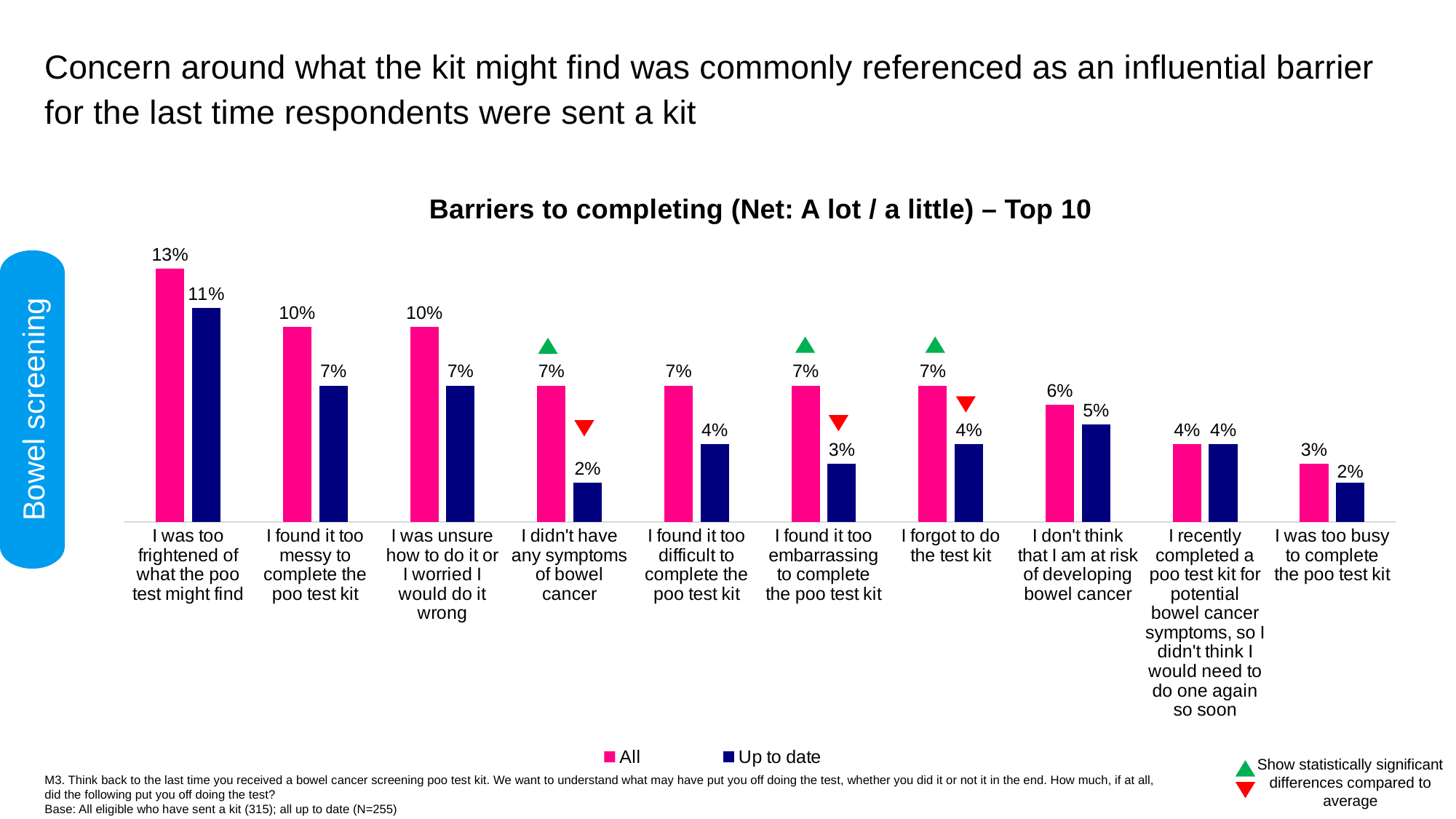
What is the title of the chart? Barriers to completing (Net: A lot / a little) – Top 10 How many series does the legend list? 2 Which is larger for 'I found it too embarrassing to complete the poo test kit': the 'All' value or the 'Up to date' value? All Which barrier has the lowest value for the 'All' series? I was too busy to complete the poo test kit What is the value for 'Up to date' for 'I didn't have any symptoms of bowel cancer'? 2% What is the value for 'All' for 'I was too frightened of what the poo test might find'? 13% Which barrier has the highest value for the 'All' series? I was too frightened of what the poo test might find What kind of chart is shown on the slide? Bar chart What is the value for 'Up to date' for 'I don't think that I am at risk of developing bowel cancer'? 5% What is the difference between the 'All' and 'Up to date' values for 'I found it too messy to complete the poo test kit'? 3% Do the 'All' values rise or fall from left to right across the barriers? Fall How many barriers are shown on the chart? 10